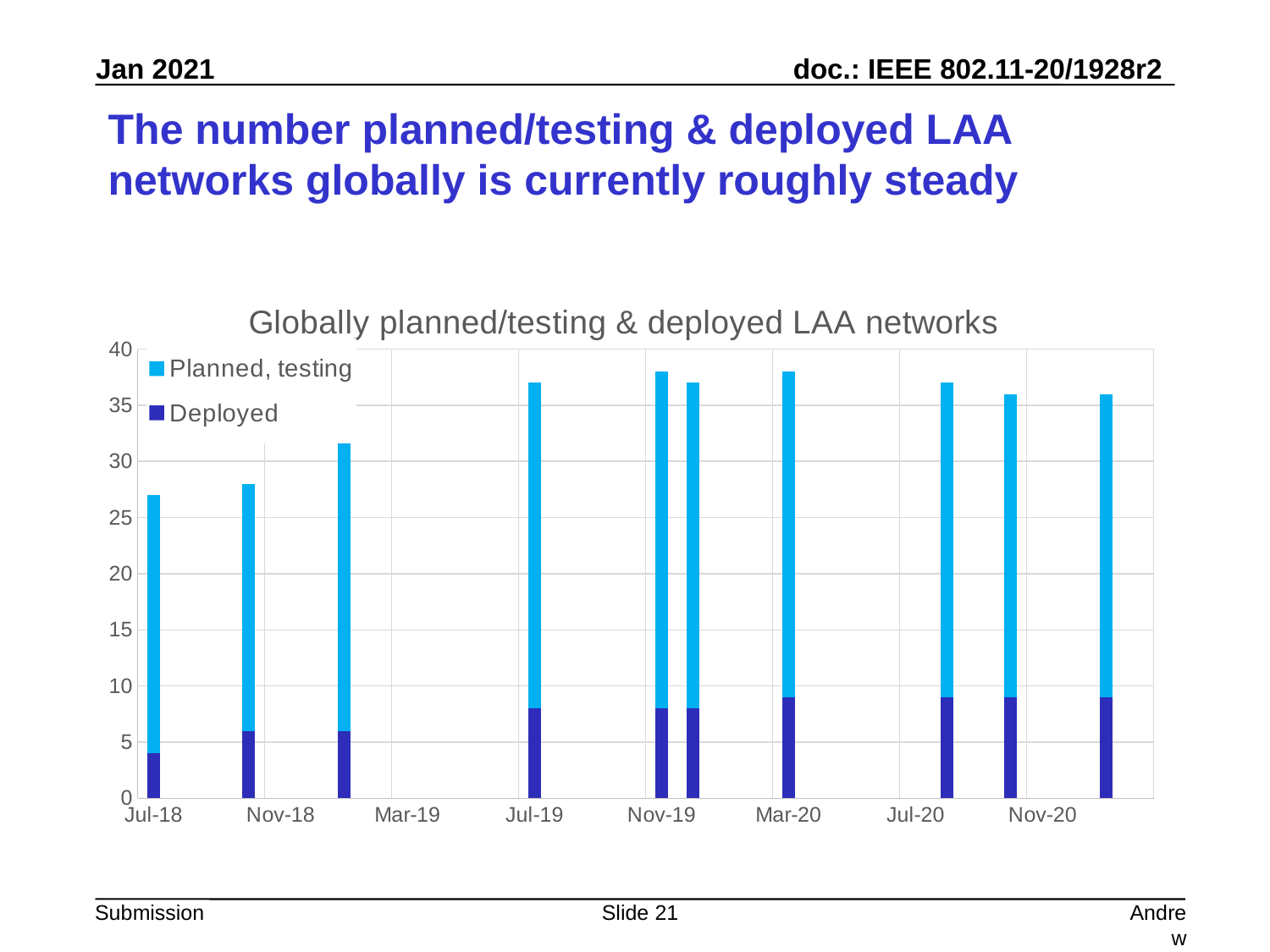
Is the total height of the Jul-18 bar greater or less than 30? less How many series does the legend list? 2 How many bars are plotted in the chart? 10 Which bar has the lowest total value? Jul-18 Do the total values rise or fall from Jul-18 to Jul-19? rise Is the Deployed value for Mar-20 greater or less than 5? greater Which has the larger total value, the Jul-18 bar or the Jul-19 bar? Jul-19 Is the Deployed value for Jul-18 greater or less than 5? less What is the title of the chart? Globally planned/testing & deployed LAA networks What kind of chart is shown on the slide? Stacked bar chart What are the two series named in the legend? Planned, testing; Deployed